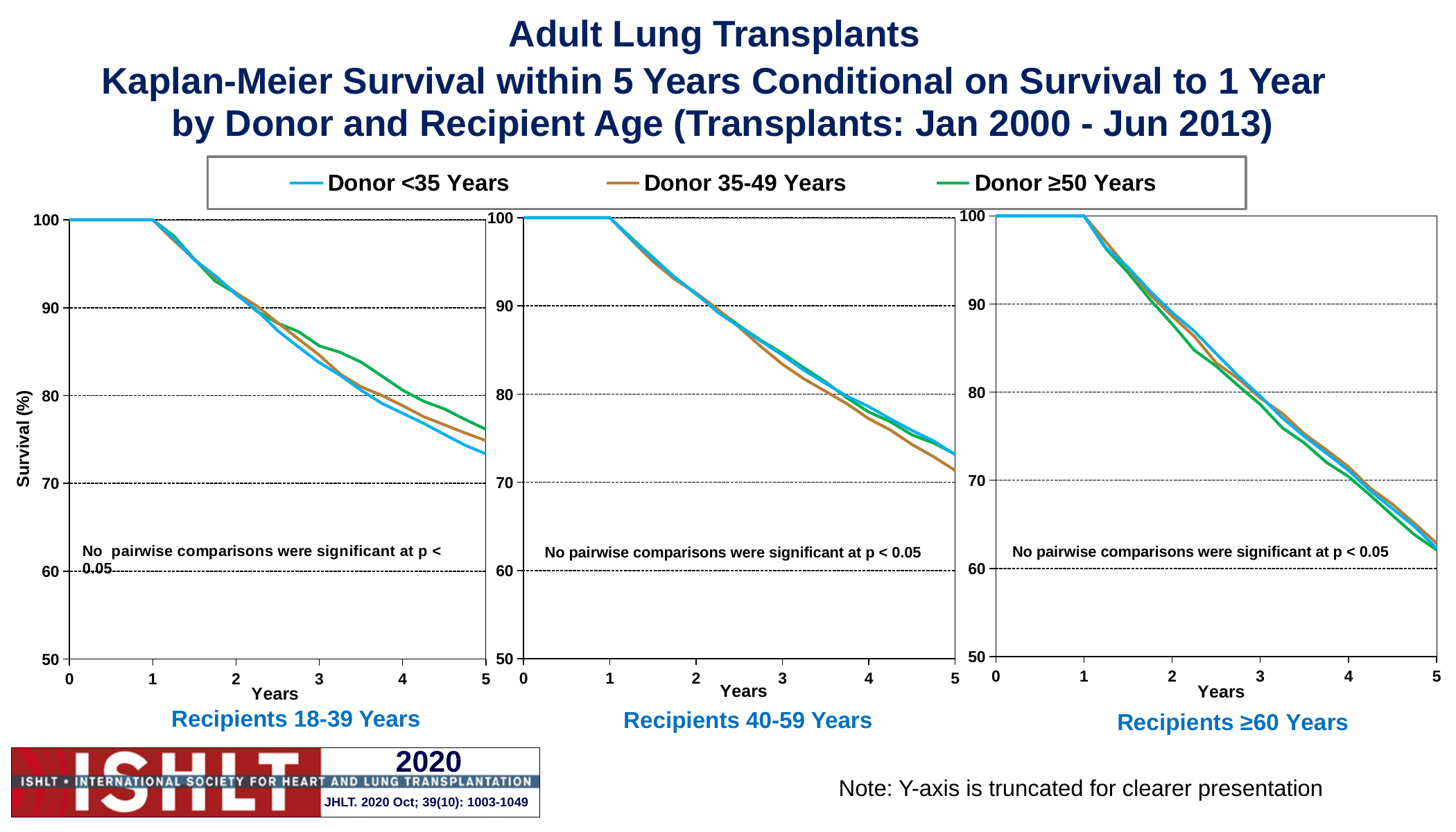
In the 'Recipients 40-59 Years' chart, do the survival curves rise or fall as years increase? Fall How many separate survival charts are shown on the slide? 3 In the 'Recipients 40-59 Years' chart, which donor age group has the lowest survival at year 5? Donor 35-49 Years In the 'Recipients ≥60 Years' chart, is the survival for Donor 35-49 Years at year 5 greater or less than 60? greater In the 'Recipients ≥60 Years' chart, what is the survival (%) for Donor <35 Years at year 1? 100 In the 'Recipients ≥60 Years' chart, is the survival for Donor ≥50 Years at year 5 greater or less than 70? less Which colour represents Donor 35-49 Years in the legend? Orange/brown In the 'Recipients 40-59 Years' chart, is the survival for Donor <35 Years at year 5 greater or less than 70? greater In the 'Recipients 18-39 Years' chart, which is larger at year 3: the survival for Donor ≥50 Years or for Donor <35 Years? Donor ≥50 Years How many series does the legend list? 3 What kind of chart is used in the 'Recipients 18-39 Years' panel? Line chart